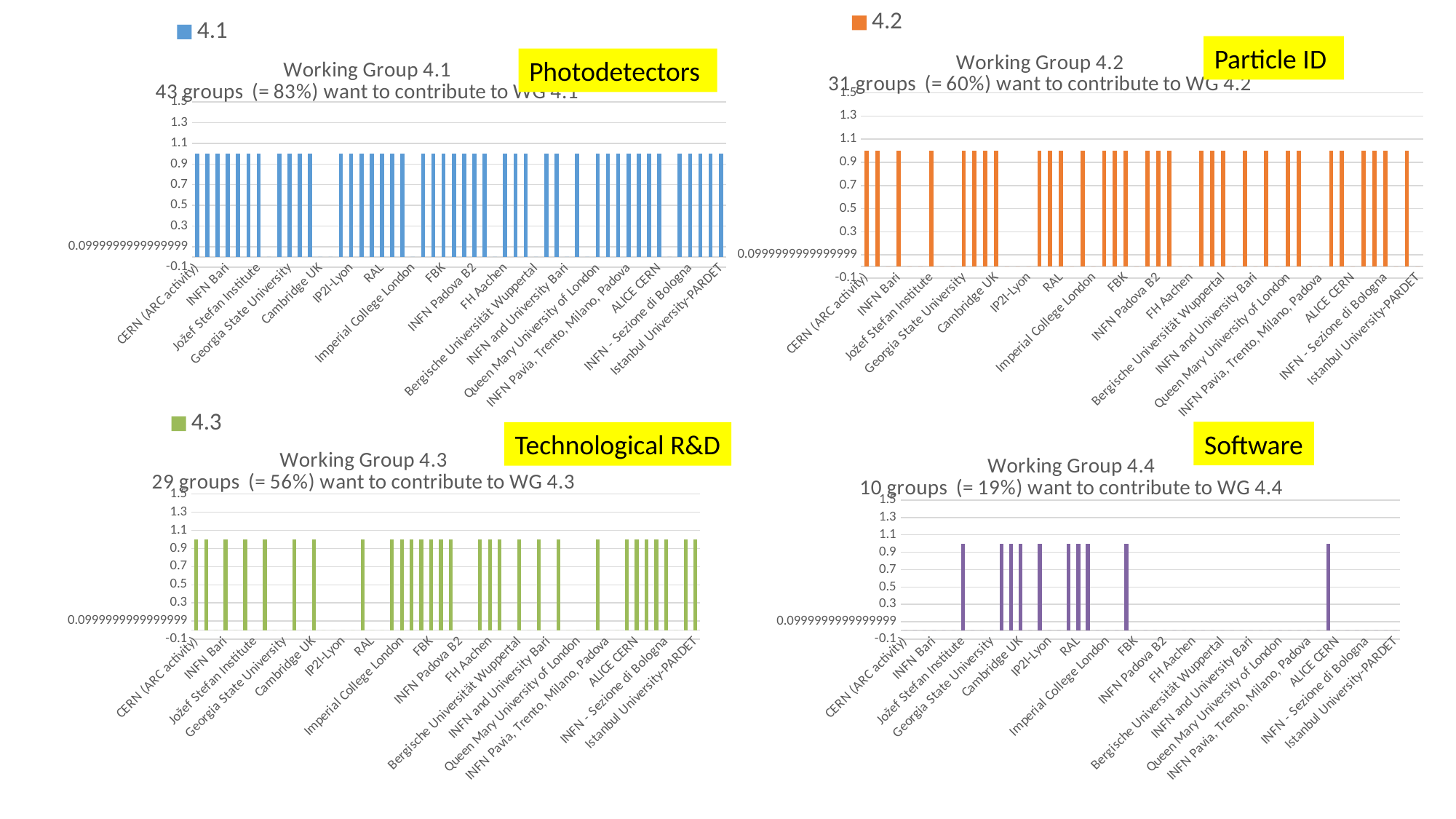
How many series does the legend of the Working Group 4.1 chart list? 1 In the Working Group 4.3 chart, is the value for CERN (ARC activity) greater or less than 0.5? greater What is the legend entry of the Working Group 4.2 chart? 4.2 In the Working Group 4.1 chart, is the value for CERN (ARC activity) greater or less than 0.5? greater In the Working Group 4.2 chart, is the value for CERN (ARC activity) greater or less than 0.5? greater What kind of chart is the Working Group 4.1 chart? bar chart What kind of chart is the Working Group 4.4 chart? bar chart According to the chart titles, what percentage of groups want to contribute to WG 4.4? 19% Which working group chart is labelled with the yellow tag 'Software'? Working Group 4.4 How many series does the legend of the Working Group 4.3 chart list? 1 According to the chart titles, how many groups want to contribute to WG 4.2? 31 groups According to the chart titles, which working group has the most groups wanting to contribute? Working Group 4.1